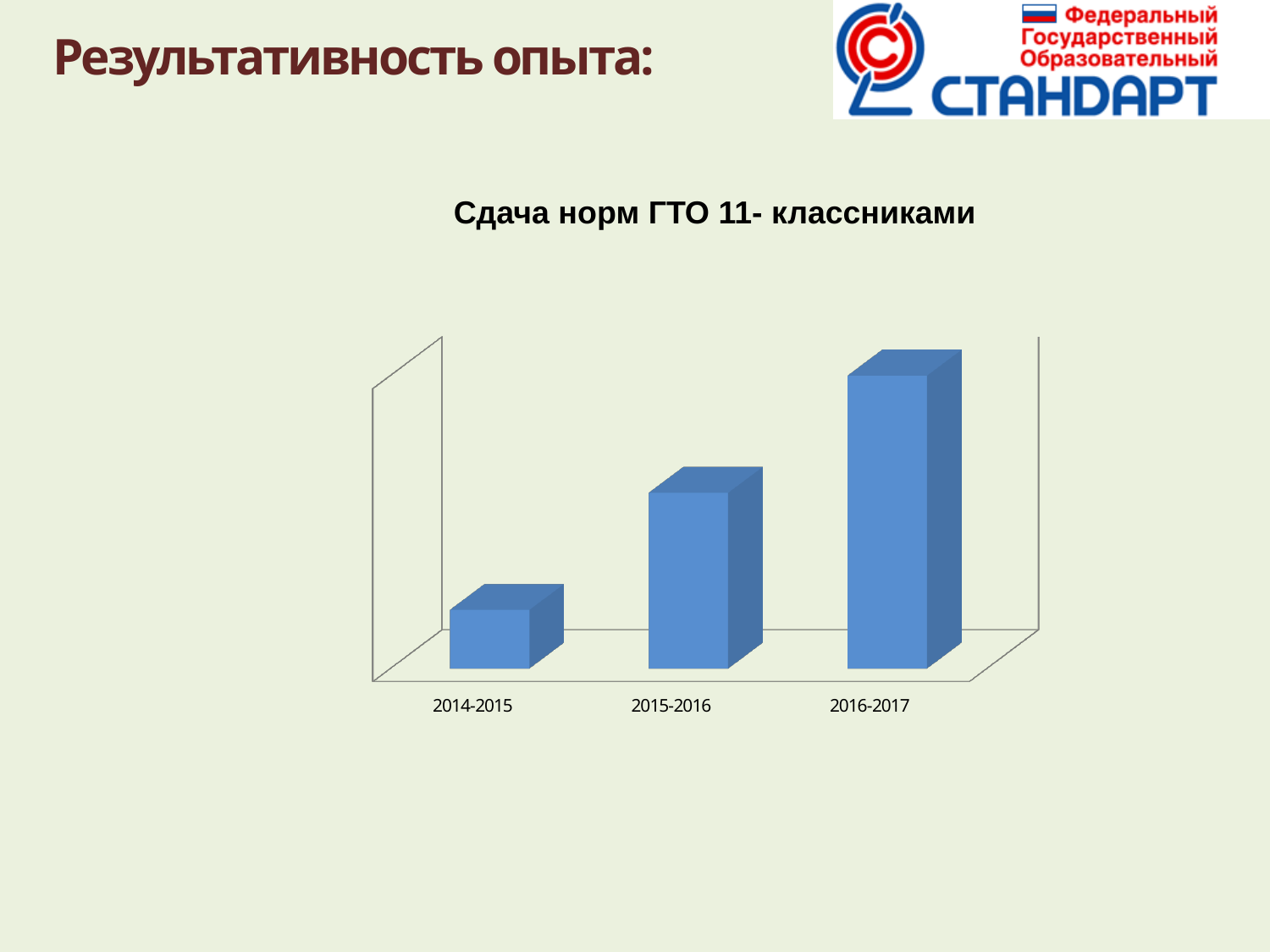
What is the label of the first category on the x axis? 2014-2015 Which category has the highest bar in the chart? 2016-2017 What is the label of the last category on the x axis? 2016-2017 Which is larger, the value for 2015-2016 or the value for 2014-2015? 2015-2016 What colour are the bars in the chart? blue What is the title of the chart? Сдача норм ГТО 11- классниками How many categories are shown on the x axis of the chart? 3 Do the values rise or fall from 2014-2015 to 2016-2017? rise Which category has the lowest bar in the chart? 2014-2015 Which is larger, the value for 2016-2017 or the value for 2015-2016? 2016-2017 What kind of chart is shown on the slide? bar chart